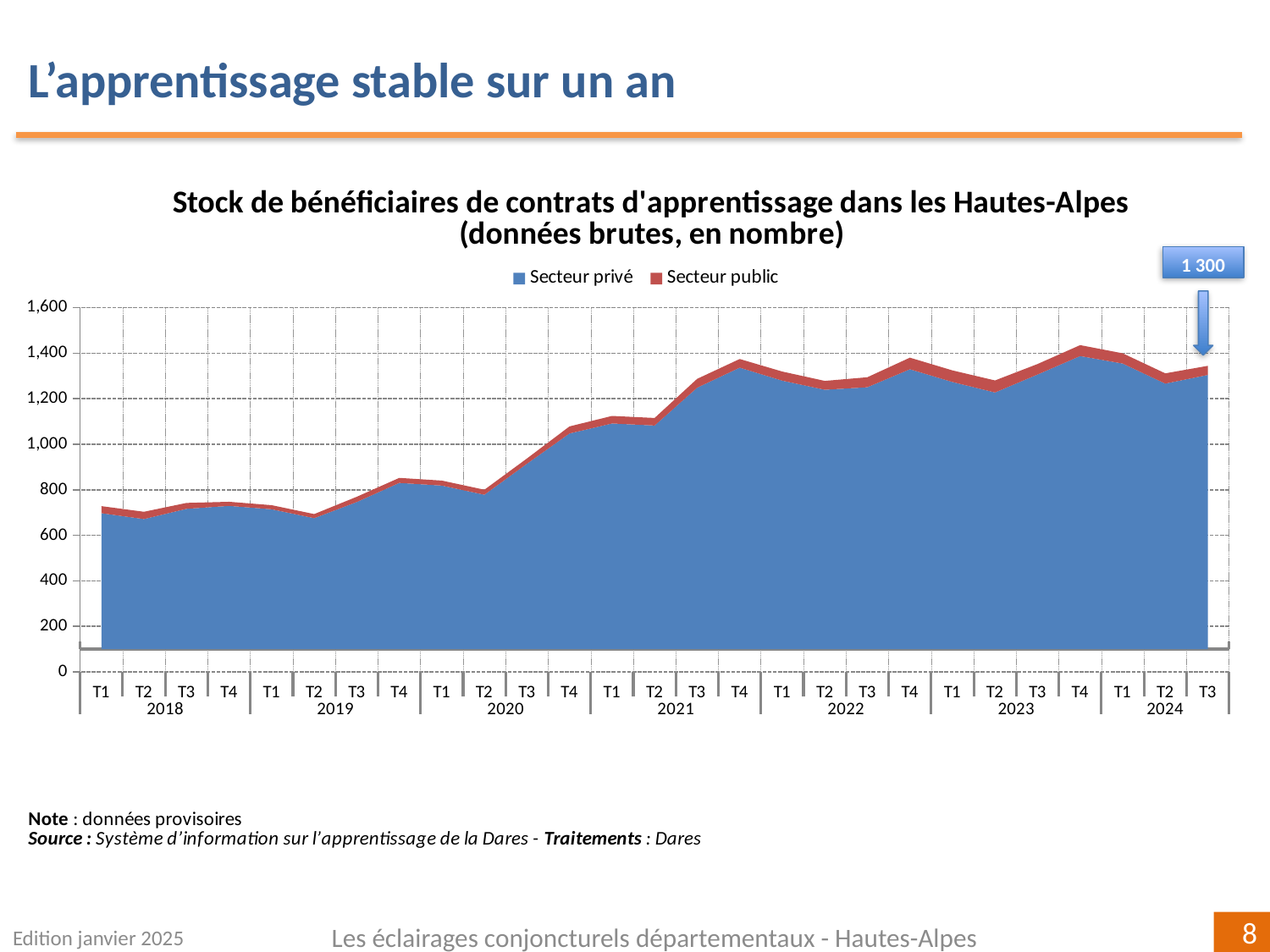
Which quarter shows the highest total stock of apprenticeship contracts? T4 2023 What are the two series named in the legend? Secteur privé and Secteur public What total value is called out for the latest quarter (T3 2024)? 1 300 Is the total value for T4 2021 greater or less than 1,200? greater How many quarterly points are plotted along the x axis? 27 Which series accounts for the larger share of the stacked area, Secteur privé or Secteur public? Secteur privé Which is larger, the total for T4 2021 or the total for T1 2018? T4 2021 What kind of chart is shown on the slide? area chart How many series does the legend list? 2 Is the total value for T1 2018 greater or less than 800? less Is the total value for T3 2020 greater or less than 1,000? less Overall, do the values rise or fall from 2018 to 2024? rise